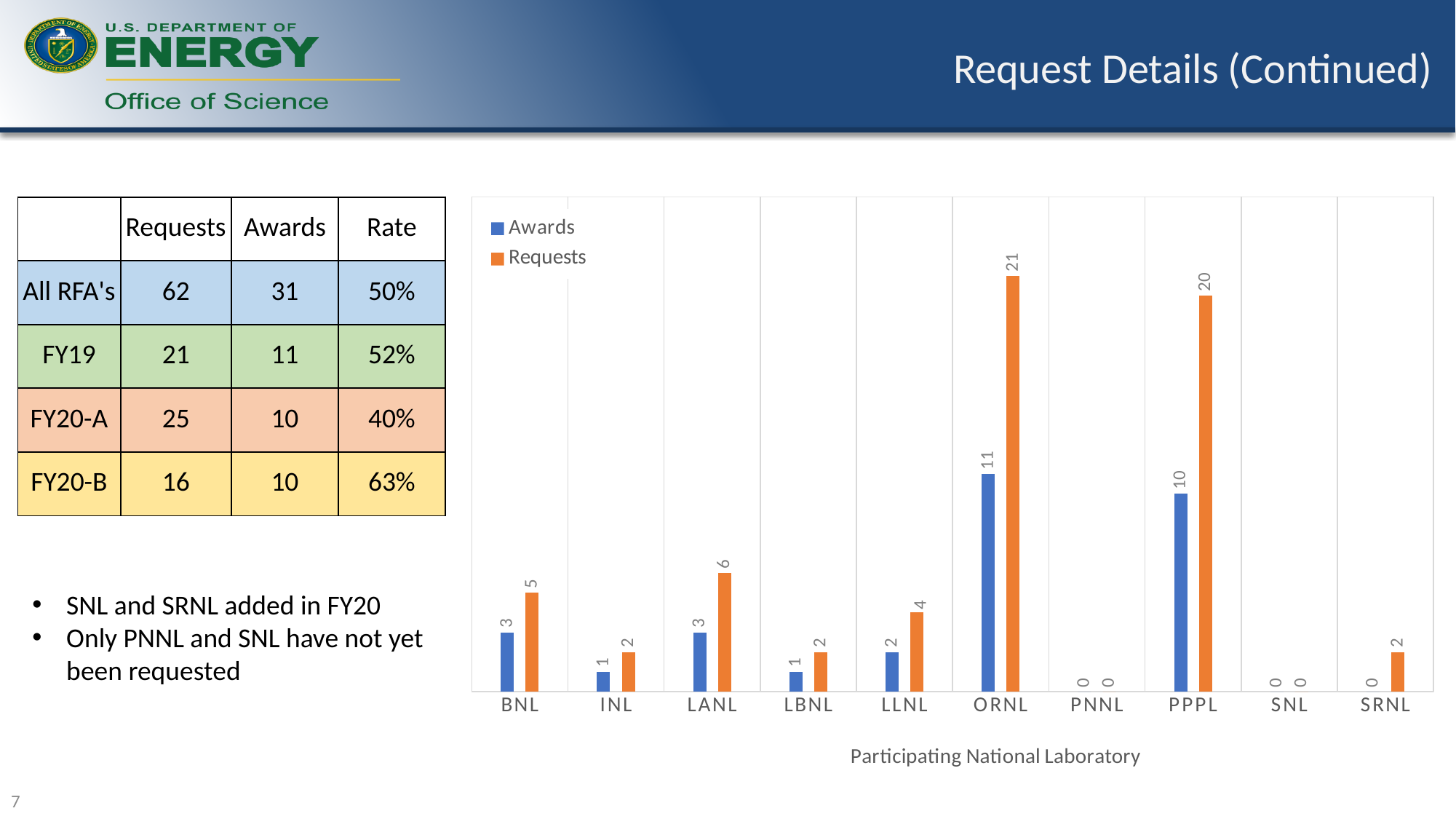
Which laboratory has the highest number of Awards? ORNL How many series does the chart legend list? 2 What is the difference between Requests and Awards for PPPL? 10 What is the x-axis title of the chart? Participating National Laboratory How many laboratories are shown on the x axis of the chart? 10 How many Requests does the chart show for ORNL? 21 Which is larger, the Requests value for BNL or the Requests value for LANL? LANL What kind of chart is shown on the slide? Bar chart What is the difference between Requests and Awards for ORNL? 10 What is the Requests value for LANL? 6 Which laboratory has the highest number of Requests? ORNL How many Awards does the chart show for PPPL? 10